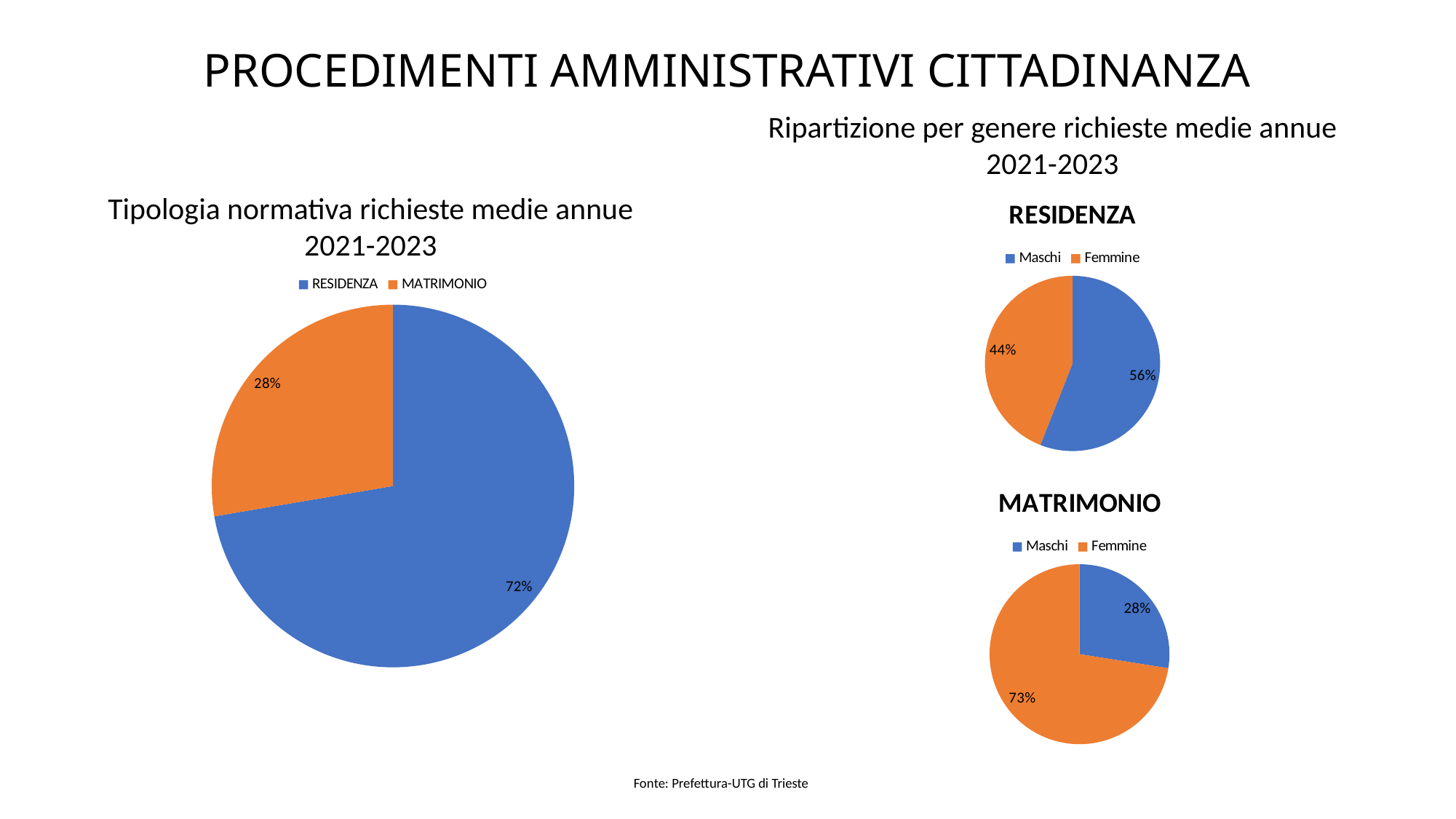
In the 'Tipologia normativa richieste medie annue 2021-2023' chart, what is the difference in percentage points between RESIDENZA and MATRIMONIO? 44 How many slices does the MATRIMONIO pie chart have? 2 What kind of chart is the 'Tipologia normativa richieste medie annue 2021-2023' chart? Pie chart In the MATRIMONIO pie chart, which category has the smallest slice? Maschi In the MATRIMONIO pie chart, what share is Femmine? 73% In the RESIDENZA pie chart, what share is Maschi? 56% In the 'Tipologia normativa richieste medie annue 2021-2023' chart, what share does RESIDENZA have? 72% In the RESIDENZA pie chart, which is larger, Maschi or Femmine? Maschi In the 'Tipologia normativa richieste medie annue 2021-2023' chart, which category has the largest slice? RESIDENZA